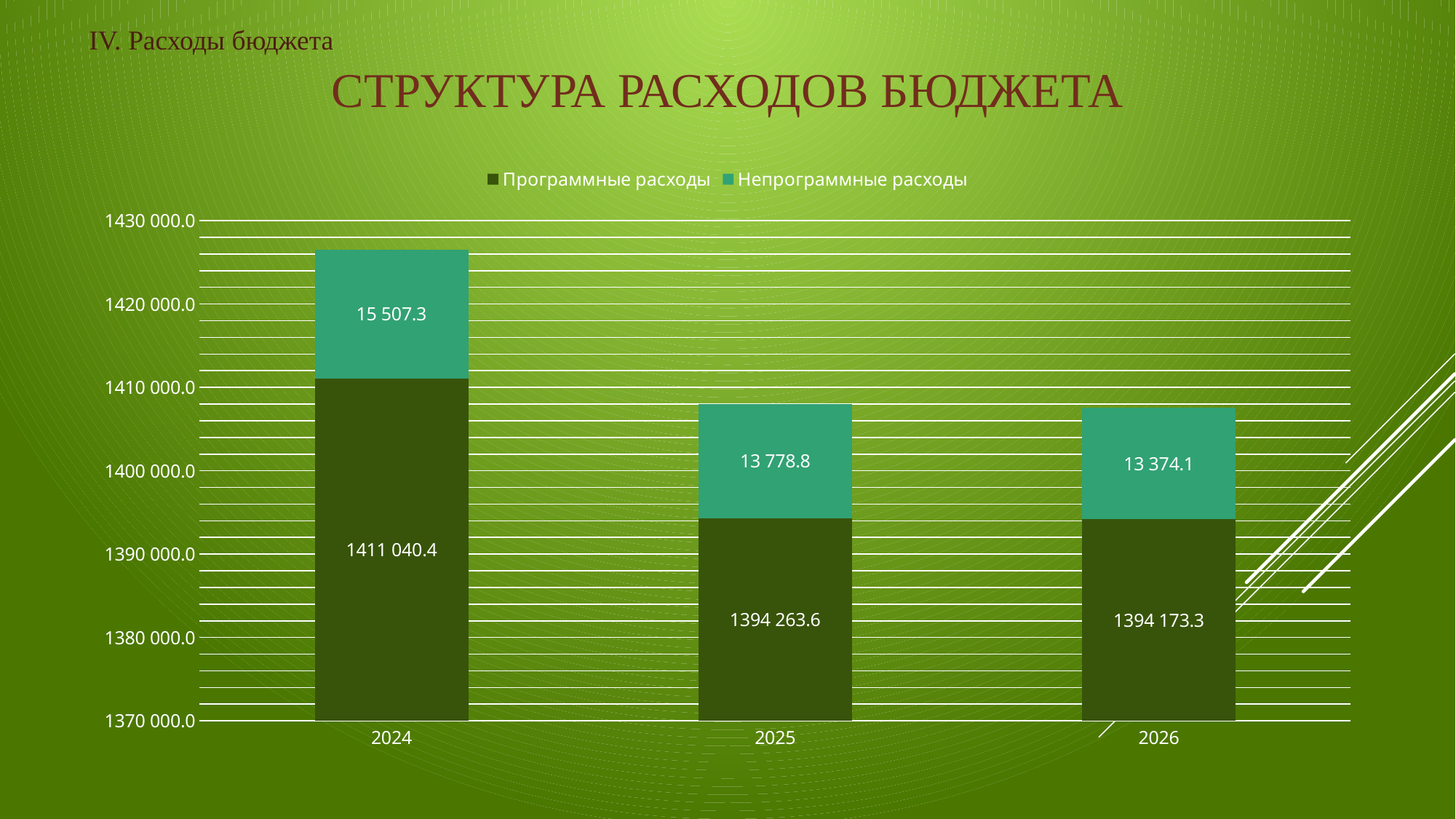
What is the value of Непрограммные расходы for 2026? 13 374.1 Is the value of Программные расходы for 2024 greater or less than 1400 000.0? greater What is the value of Программные расходы for 2024? 1411 040.4 How many years (categories) are shown on the x axis? 3 How many series does the legend list? 2 Which year has the highest value of Непрограммные расходы? 2024 Which year has the lowest value of Программные расходы? 2026 What is the value of Непрограммные расходы for 2025? 13 778.8 What is the total of the stacked bar for 2025? 1408 042.4 What type of chart is shown on the slide? Stacked bar chart What is the difference between Программные расходы in 2025 and 2026? 90.3 What is the difference between Непрограммные расходы in 2024 and 2025? 1 728.5